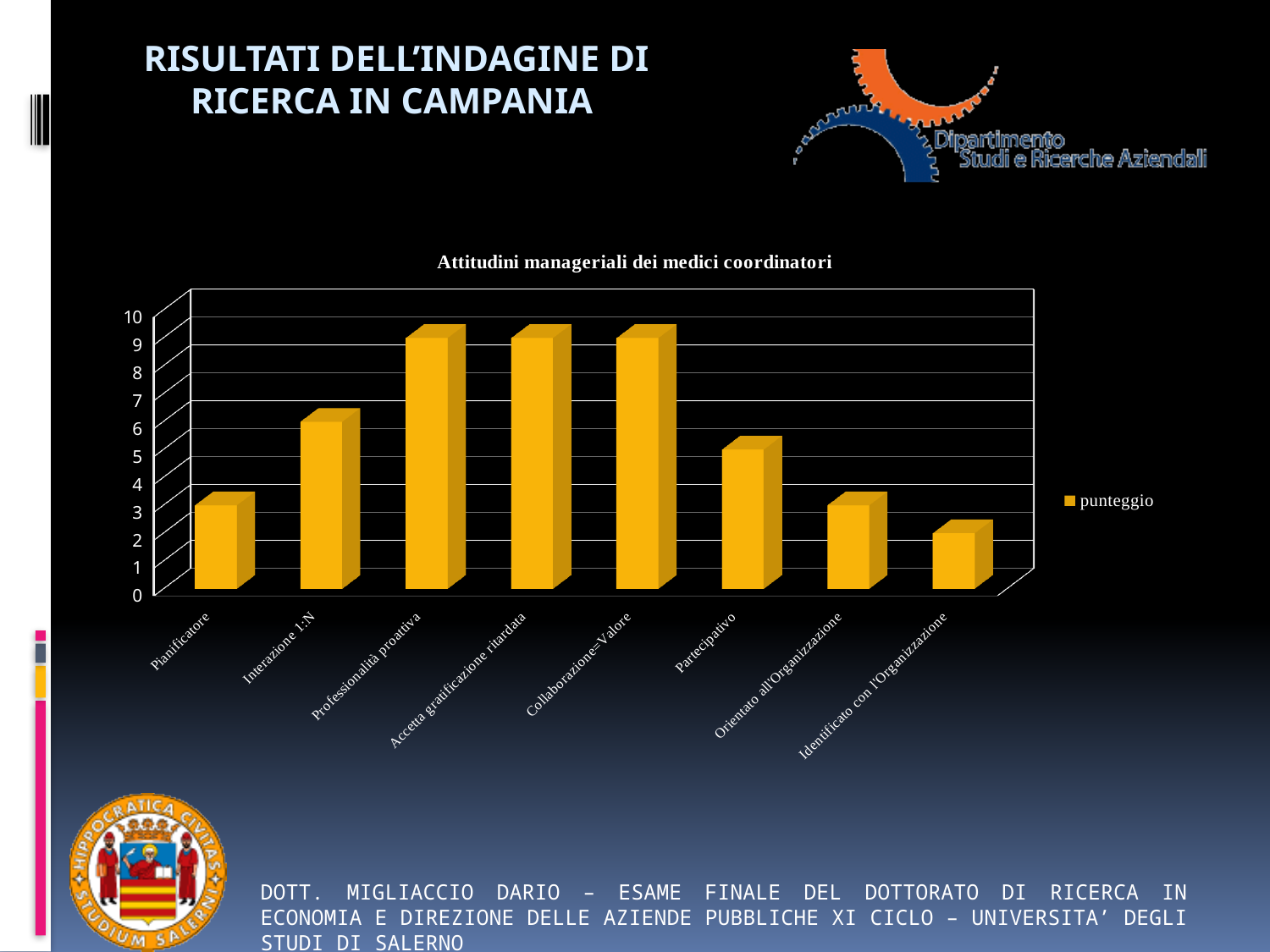
What kind of chart is shown on the slide? bar chart How many series does the chart legend list? 1 Which category has the lowest value? Identificato con l'Organizzazione Which is larger, the value for Interazione 1:N or the value for Partecipativo? Interazione 1:N What is the name of the series shown in the legend? punteggio Which is larger, the value for Accetta gratificazione ritardata or the value for Orientato all'Organizzazione? Accetta gratificazione ritardata Is the value for Collaborazione=Valore greater or less than 7? greater Is the value for Pianificatore greater or less than 5? less Is the value for Professionalità proattiva greater or less than 8? greater How many categories are plotted on the x axis? 8 What is the title of the chart? Attitudini manageriali dei medici coordinatori